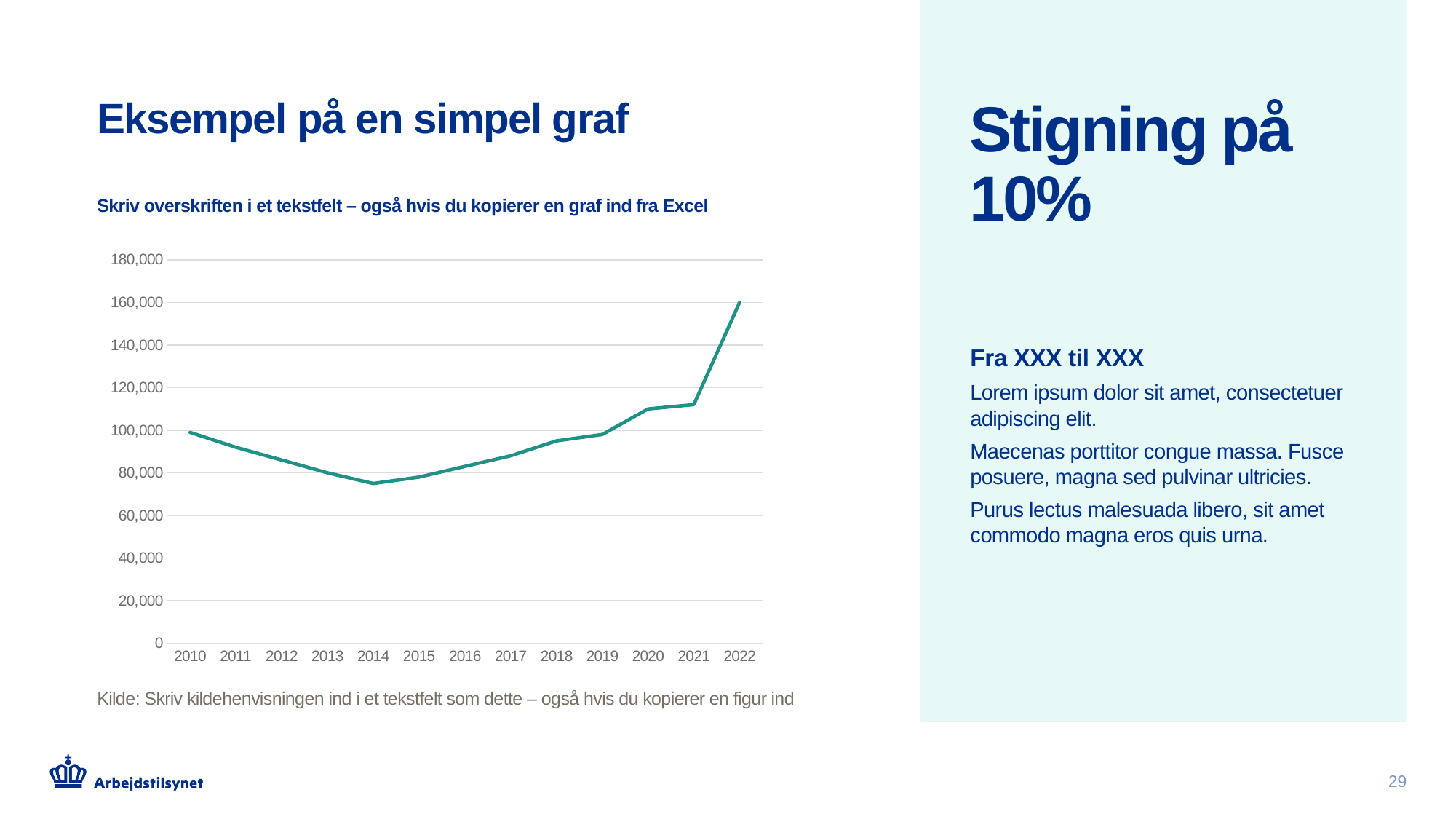
What kind of chart is shown on the slide? line chart Is the value for 2020 greater or less than 100,000? greater Is the value for 2010 greater or less than 120,000? less Is the value for 2014 greater or less than 80,000? less Which year has the larger value, 2010 or 2014? 2010 What is the first year shown on the x axis of the chart? 2010 Which year has the larger value, 2021 or 2022? 2022 How many years are plotted along the x axis of the chart? 13 Do the values rise or fall between 2014 and 2022? rise Which year has the highest value in the chart? 2022 Which year has the lowest value in the chart? 2014